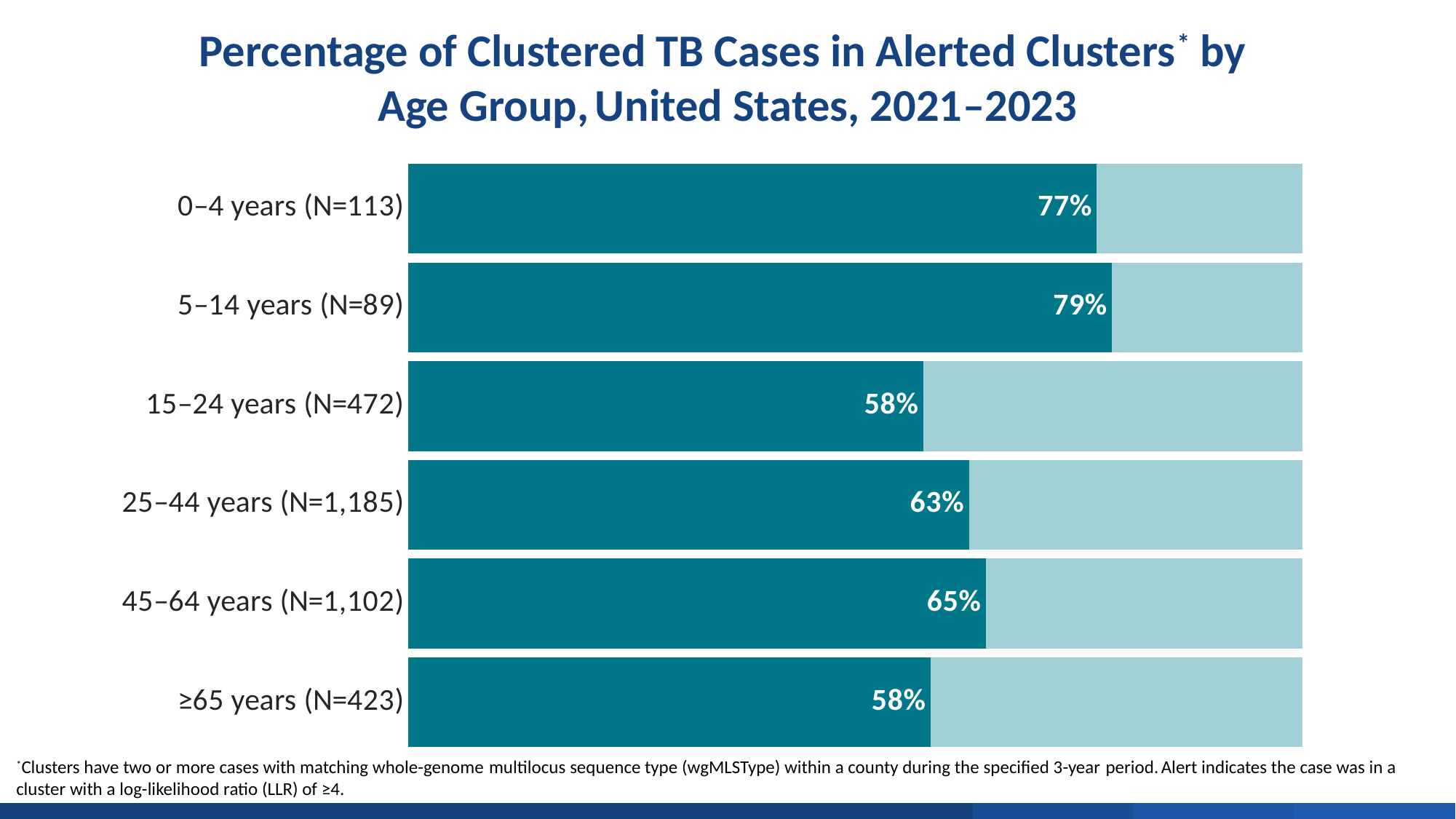
What kind of chart is shown on the slide? Bar chart Which age group has the highest percentage of clustered TB cases in alerted clusters? 5–14 years Which has a higher percentage of clustered TB cases in alerted clusters: 25–44 years or 45–64 years? 45–64 years What percentage of clustered TB cases were in alerted clusters for the 45–64 years age group? 65% What is the difference in percentage points between the 5–14 years and 15–24 years age groups? 21 What percentage of clustered TB cases were in alerted clusters for the 0–4 years age group? 77% What percentage of clustered TB cases were in alerted clusters for the 25–44 years age group? 63% What is the number of cases (N) for the 25–44 years age group? 1,185 Which two age groups share the lowest percentage of clustered TB cases in alerted clusters? 15–24 years and ≥65 years How many age groups are shown in the chart? 6 What is the difference in percentage points between the 0–4 years and ≥65 years age groups? 19 Which has a higher percentage of clustered TB cases in alerted clusters: 0–4 years or 5–14 years? 5–14 years